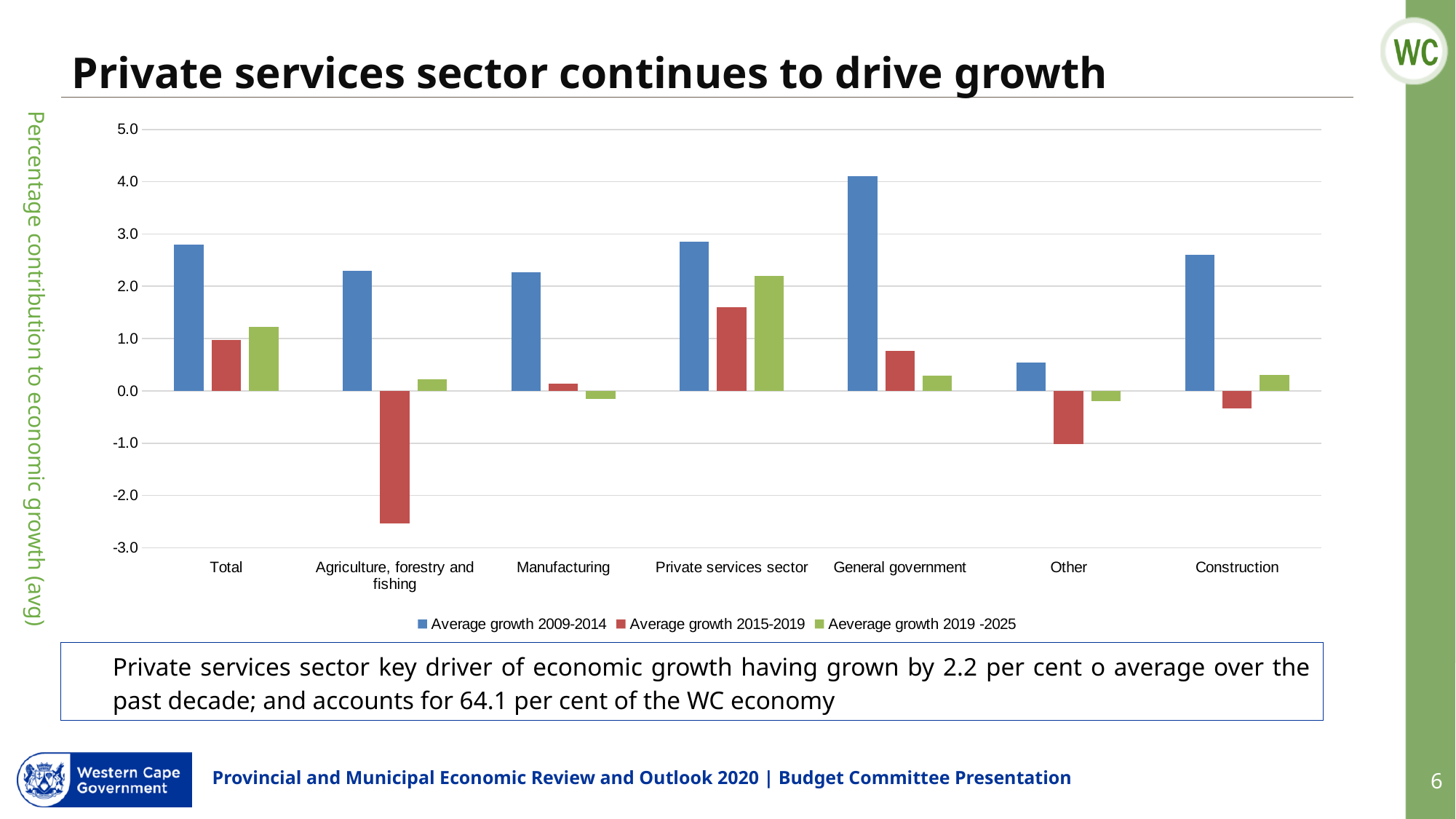
For the Total category, which is larger: Average growth 2009-2014 or Average growth 2015-2019? Average growth 2009-2014 Which category has the highest value for Aeverage growth 2019 -2025? Private services sector How many categories are shown along the x axis? 7 Is the Average growth 2009-2014 value for General government greater or less than 3.0? greater For Aeverage growth 2019 -2025, which is larger: Private services sector or General government? Private services sector Which category has the highest value for Average growth 2009-2014? General government How many series does the legend list? 3 Which category has the lowest value for Average growth 2015-2019? Agriculture, forestry and fishing Which category has the lowest value for Average growth 2009-2014? Other What is the label on the vertical axis of the chart? Percentage contribution to economic growth (avg) What kind of chart is shown on the slide? bar chart Is the Average growth 2015-2019 value for Agriculture, forestry and fishing greater or less than -2.0? less